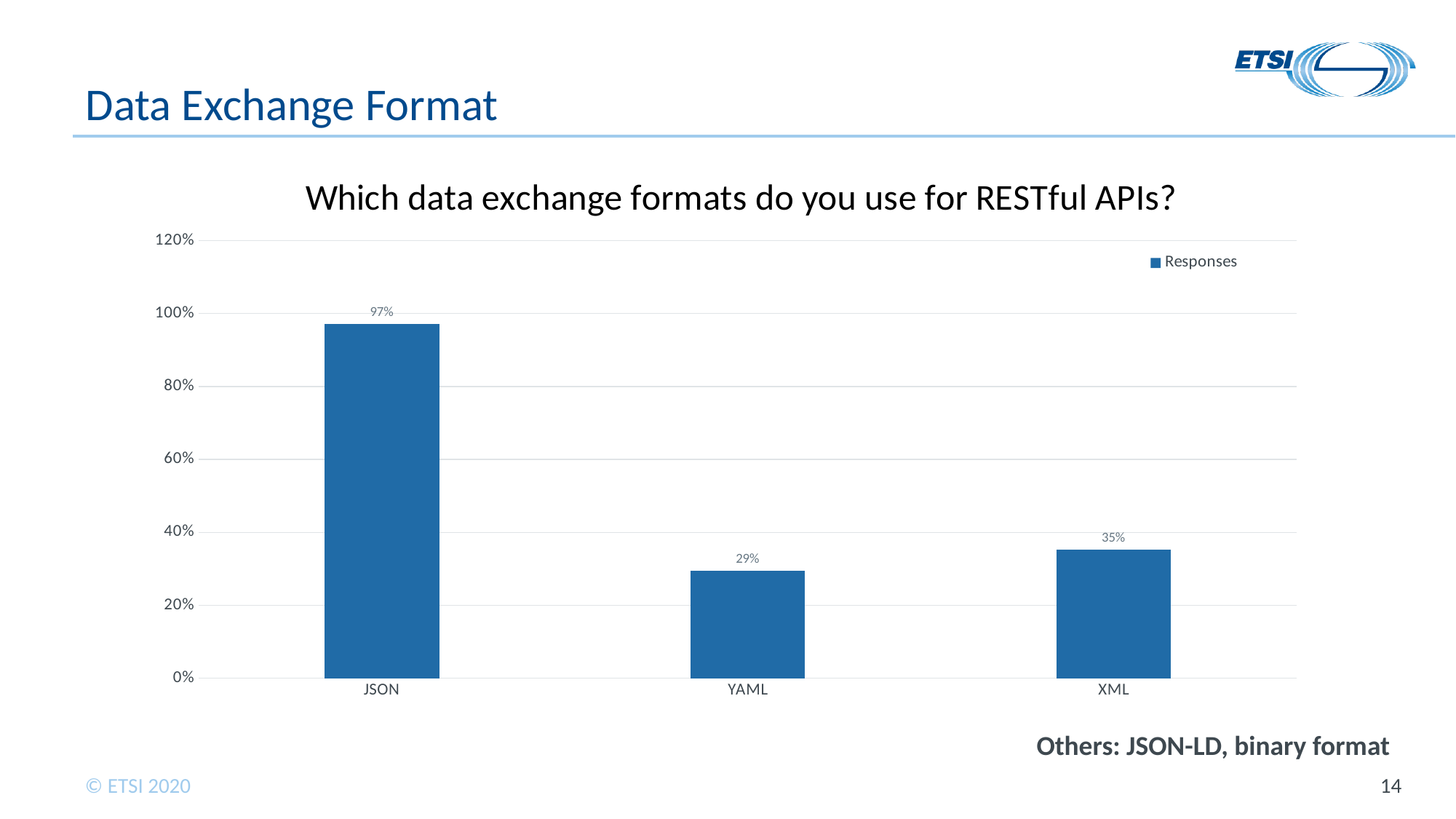
Which has a larger share of responses, XML or YAML? XML What is the difference in percentage points between XML and YAML? 6% How many data exchange formats are shown in the chart? 3 What type of chart is shown on the slide? bar chart What percentage of responses use JSON for RESTful APIs? 97% Is the value for XML greater or less than 40%? less What is the name of the series listed in the chart legend? Responses What is the difference in percentage points between JSON and XML? 62% Which data exchange format has the highest share of responses? JSON Which data exchange format has the lowest share of responses? YAML What percentage of responses use XML for RESTful APIs? 35% What percentage of responses use YAML for RESTful APIs? 29%